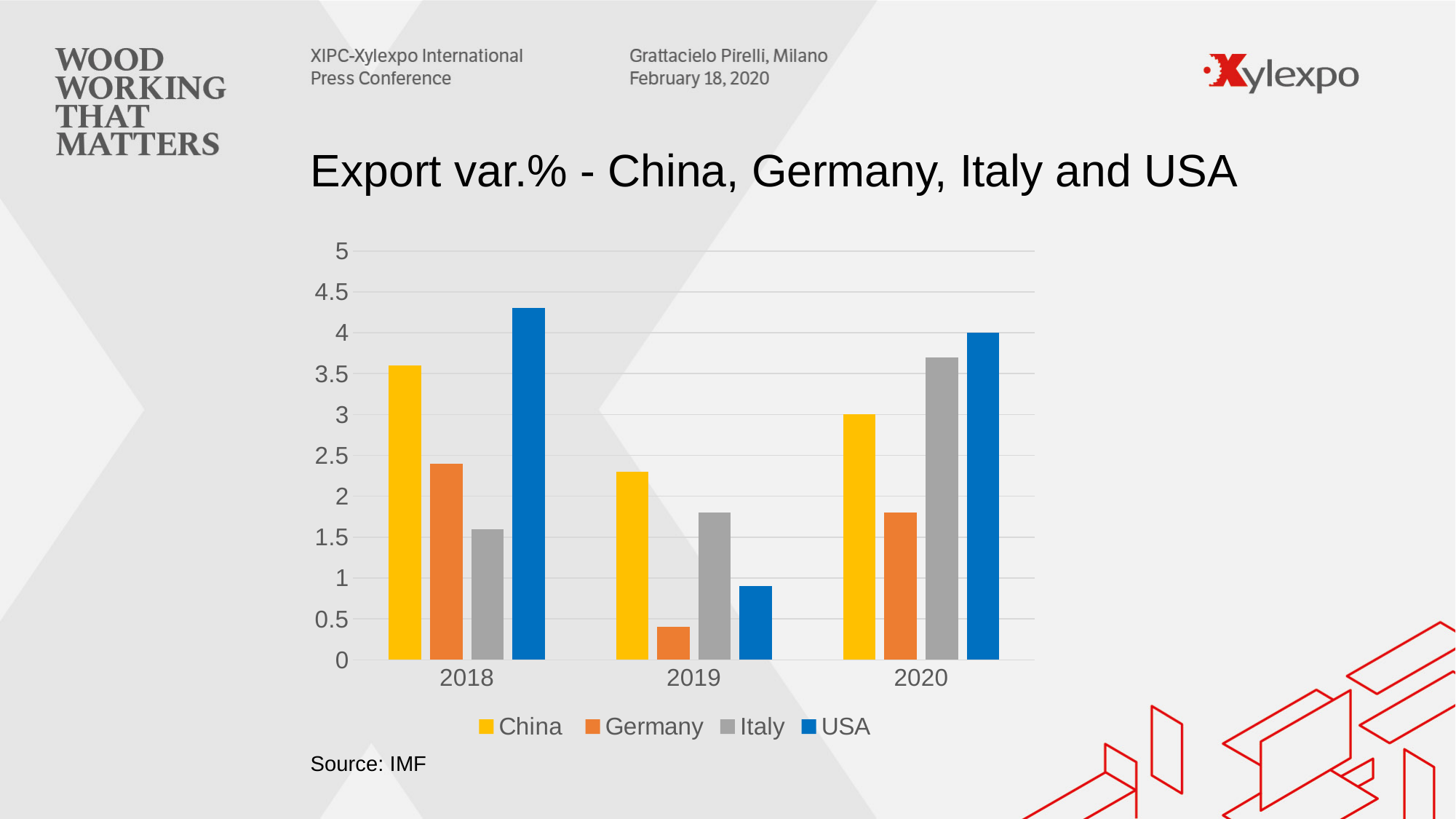
How many year categories are shown on the x axis? 3 How many series does the legend list? 4 What is the value for USA in 2020? 4 Which is larger in 2020, the value for Italy or the value for Germany? Italy What is the value for China in 2020? 3 Which series has the lowest value in 2018? Italy Is the value for Germany in 2019 greater or less than 0.5? less Which series has the lowest value in 2019? Germany Which series has the highest value in 2018? USA What kind of chart is shown on the slide? bar chart Does the value for USA rise or fall from 2018 to 2019? fall Is the value for USA in 2018 greater or less than 4? greater